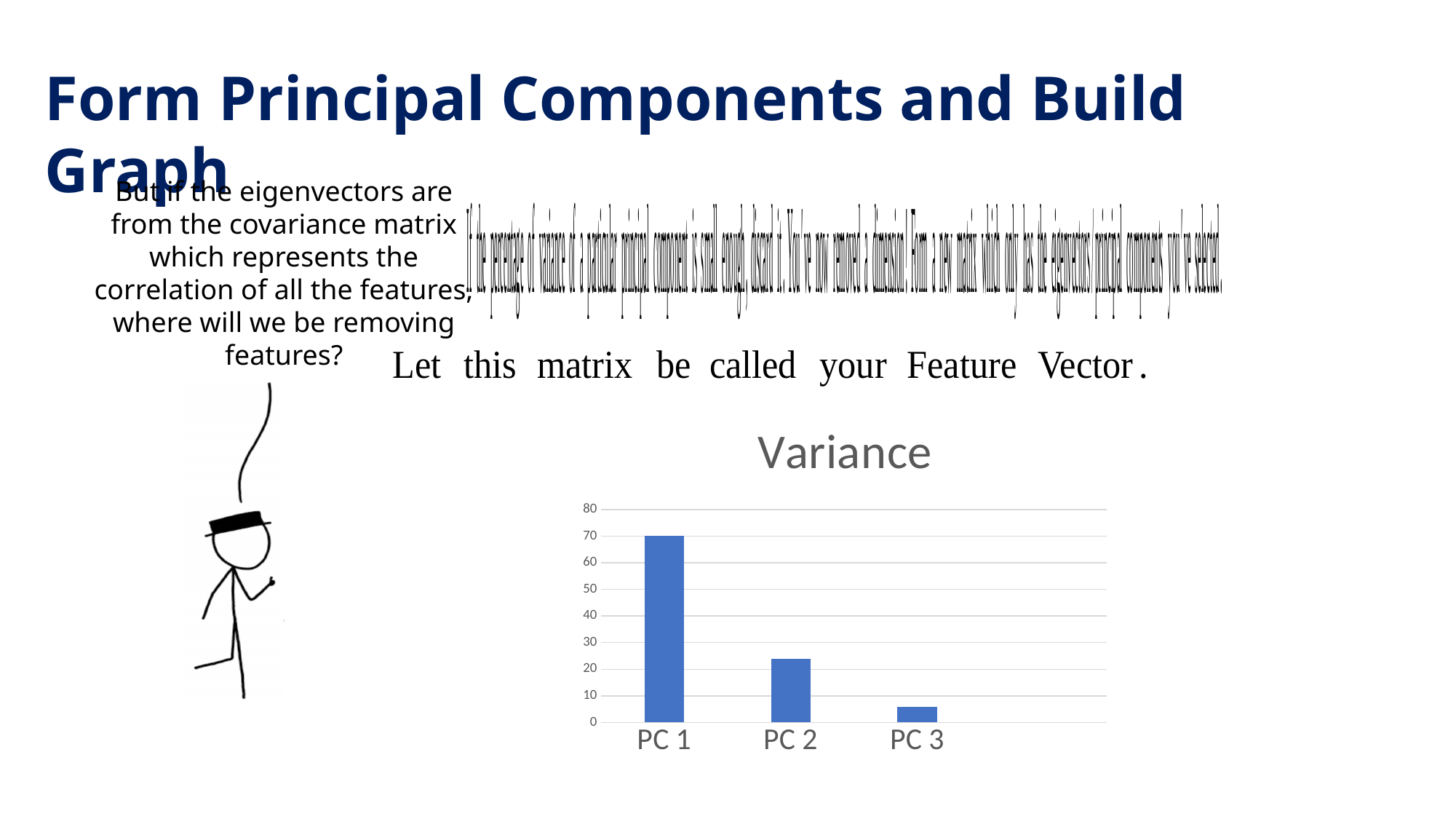
In the Variance chart, is the value for PC 2 greater or less than 20? greater What is the title of the chart on the slide? Variance In the Variance chart, which is larger, the value for PC 2 or the value for PC 3? PC 2 Do the values in the Variance chart rise or fall from PC 1 to PC 3? fall In the Variance chart, is the value for PC 1 greater or less than 60? greater How many categories are plotted in the Variance chart? 3 Which category has the highest value in the Variance chart? PC 1 In the Variance chart, is the value for PC 2 greater or less than 30? less What is the highest value shown on the vertical axis of the Variance chart? 80 What kind of chart is shown under the title "Variance"? bar chart Which category has the lowest value in the Variance chart? PC 3